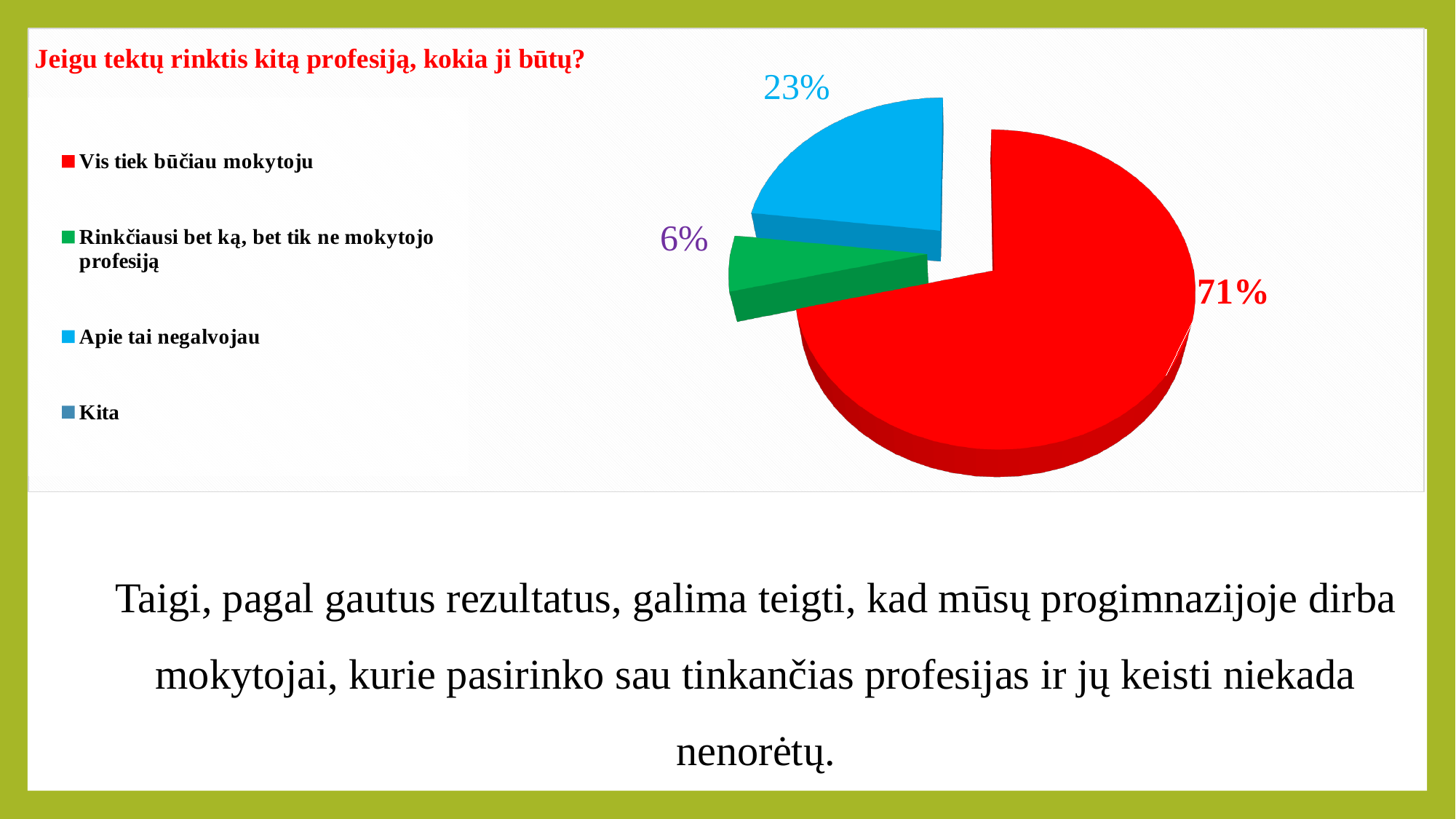
How many percentage points larger is the "Apie tai negalvojau" slice than the "Rinkčiausi bet ką, bet tik ne mokytojo profesiją" slice? 17 How many categories does the legend of the pie chart list? 4 Which category has the largest slice of the pie? Vis tiek būčiau mokytoju What colour is the slice for "Vis tiek būčiau mokytoju"? red What share of the pie does "Apie tai negalvojau" have? 23% What share of the pie does "Vis tiek būčiau mokytoju" have? 71% What kind of chart is shown on the slide? pie chart What share of the pie does "Rinkčiausi bet ką, bet tik ne mokytojo profesiją" have? 6% Which is larger: the share for "Apie tai negalvojau" or the share for "Rinkčiausi bet ką, bet tik ne mokytojo profesiją"? Apie tai negalvojau How many percentage points larger is the "Vis tiek būčiau mokytoju" slice than the "Apie tai negalvojau" slice? 48 Of the slices with a printed percentage, which category has the smallest share? Rinkčiausi bet ką, bet tik ne mokytojo profesiją What is the title of the pie chart? Jeigu tektų rinktis kitą profesiją, kokia ji būtų?